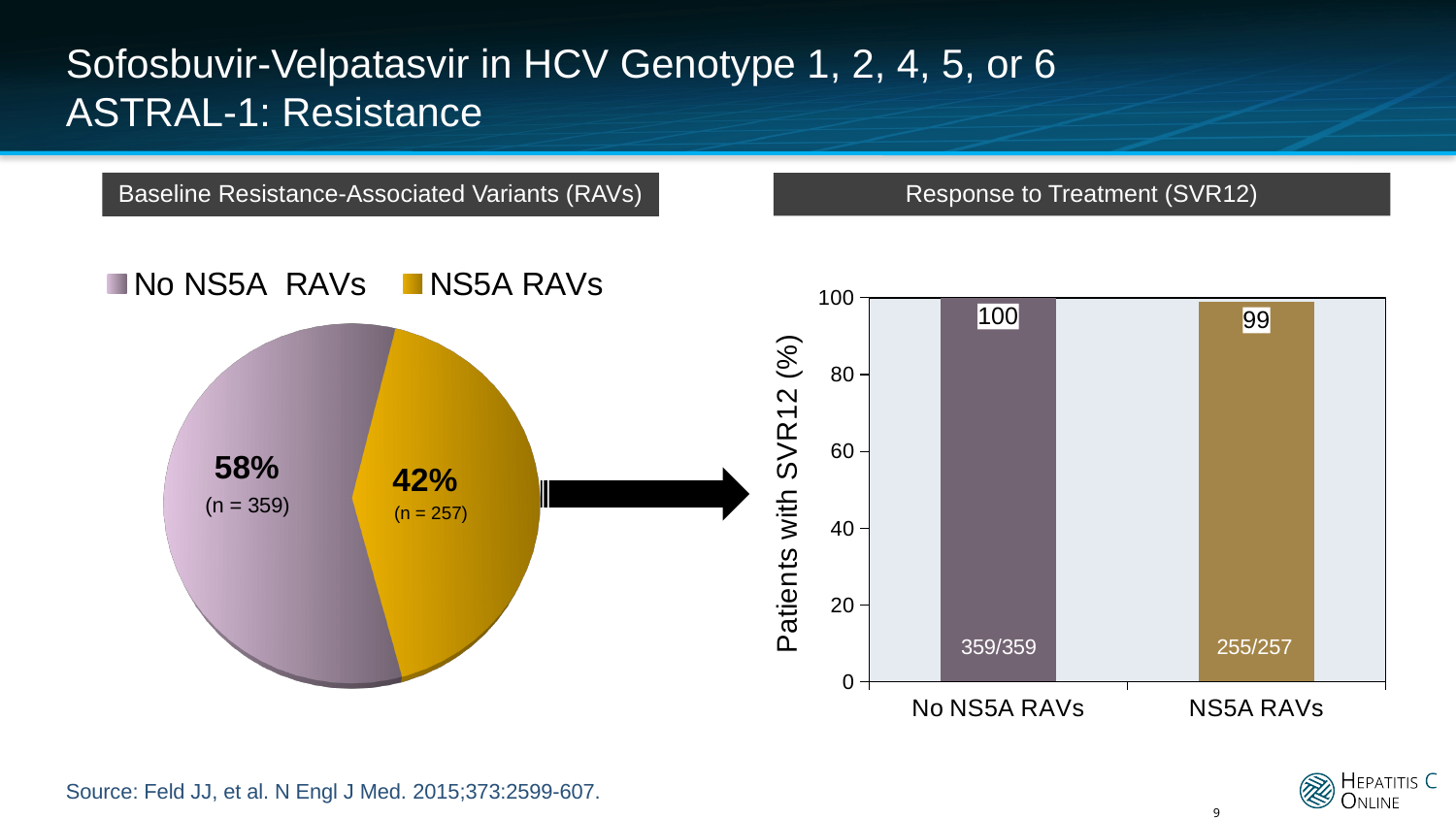
In the Response to Treatment (SVR12) chart, what is the SVR12 percentage for NS5A RAVs? 99 What is the y-axis label of the Response to Treatment (SVR12) chart? Patients with SVR12 (%) In the Baseline Resistance-Associated Variants (RAVs) chart, what share of the pie is NS5A RAVs? 42% What kind of chart is the Baseline Resistance-Associated Variants (RAVs) chart? Pie chart In the Response to Treatment (SVR12) chart, what fraction is printed on the NS5A RAVs bar? 255/257 In the Baseline Resistance-Associated Variants (RAVs) chart, which slice is larger? No NS5A RAVs In the Response to Treatment (SVR12) chart, what is the difference in SVR12 percentage between No NS5A RAVs and NS5A RAVs? 1 What kind of chart is the Response to Treatment (SVR12) chart? Bar chart How many entries does the legend of the Baseline Resistance-Associated Variants (RAVs) chart list? 2 In the Baseline Resistance-Associated Variants (RAVs) chart, what share of the pie is No NS5A RAVs? 58% In the Response to Treatment (SVR12) chart, what is the SVR12 percentage for No NS5A RAVs? 100 In the Baseline Resistance-Associated Variants (RAVs) chart, what is the n for the NS5A RAVs slice? n = 257